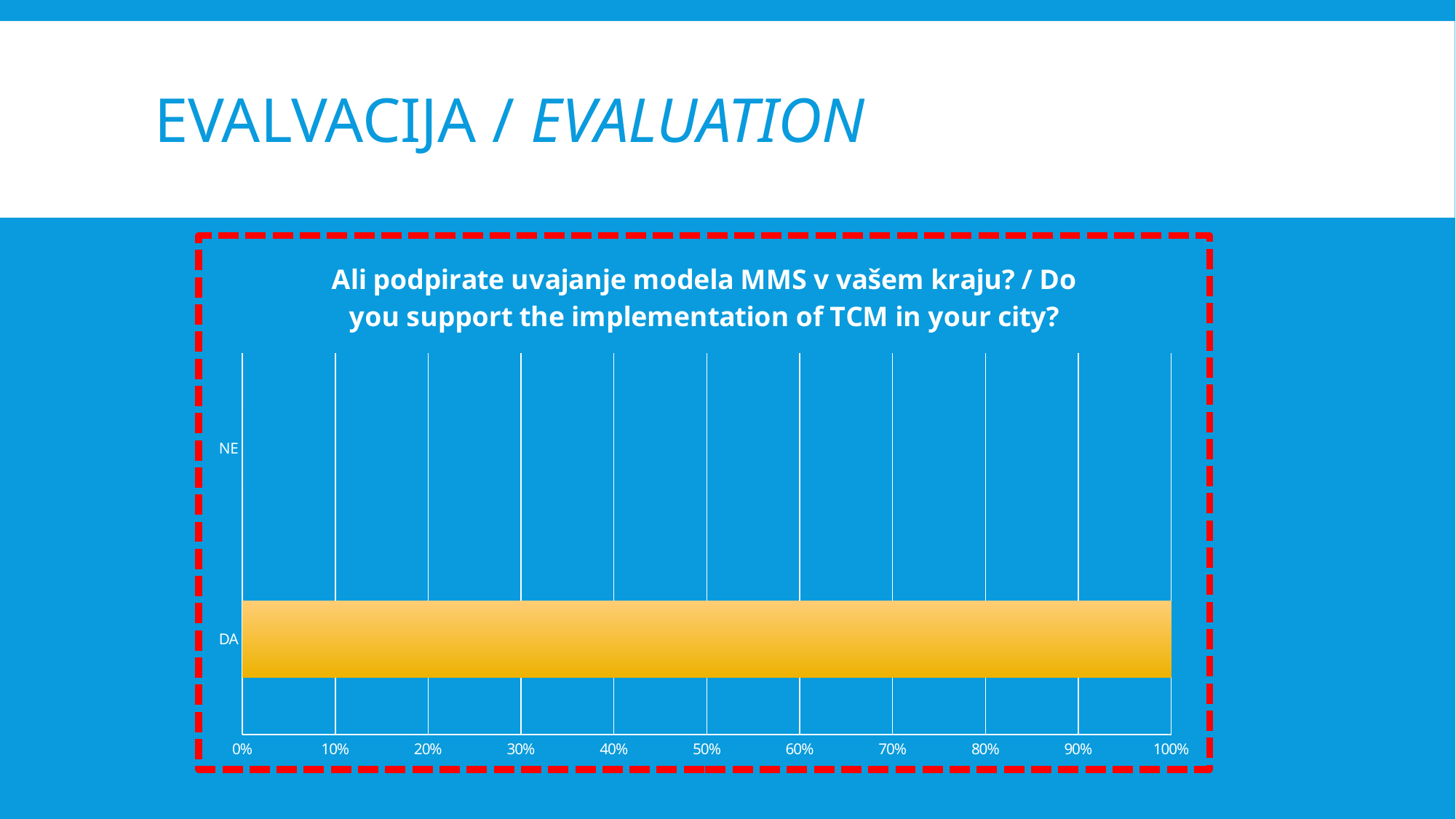
Which category has the lowest value? NE How many categories are shown on the chart? 2 Which is larger, the value for DA or the value for NE? DA What is the value for DA? 100% What type of chart is shown on the slide? bar chart Is the value for DA greater or less than 50%? greater Which category has the highest value? DA Is the value for NE greater or less than 10%? less What is the highest value shown on the x axis? 100% What is the English part of the chart title? Do you support the implementation of TCM in your city?